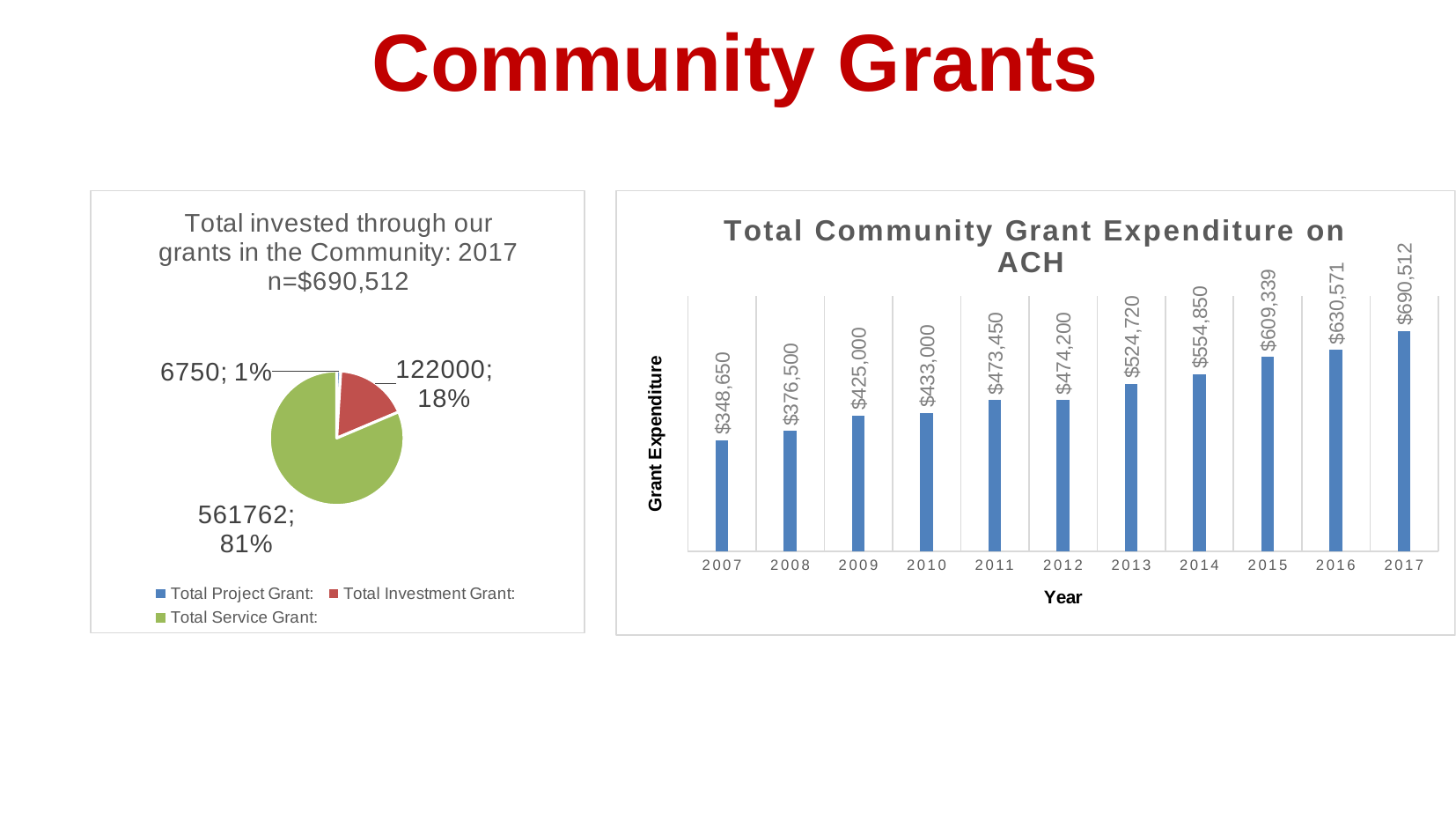
In the 'Total Community Grant Expenditure on ACH' chart, what is the difference between the 2017 and 2016 grant expenditure? $59,941 What kind of chart is the 'Total Community Grant Expenditure on ACH' chart? bar chart In the 'Total Community Grant Expenditure on ACH' chart, which year has the lowest grant expenditure? 2007 In the pie chart on the left, what share of the 2017 grants was the Total Service Grant? 81% How many entries does the legend of the pie chart on the left list? 3 In the pie chart on the left, what is the value of the Total Investment Grant? 122000 In the 'Total Community Grant Expenditure on ACH' chart, what was the grant expenditure in 2013? $524,720 In the 'Total Community Grant Expenditure on ACH' chart, which year has the highest grant expenditure? 2017 In the 'Total Community Grant Expenditure on ACH' chart, how many years are shown on the x axis? 11 In the 'Total Community Grant Expenditure on ACH' chart, what was the grant expenditure in 2007? $348,650 In the 'Total Community Grant Expenditure on ACH' chart, do the values generally rise or fall from 2007 to 2017? rise In the pie chart on the left, which grant type has the smallest share? Total Project Grant